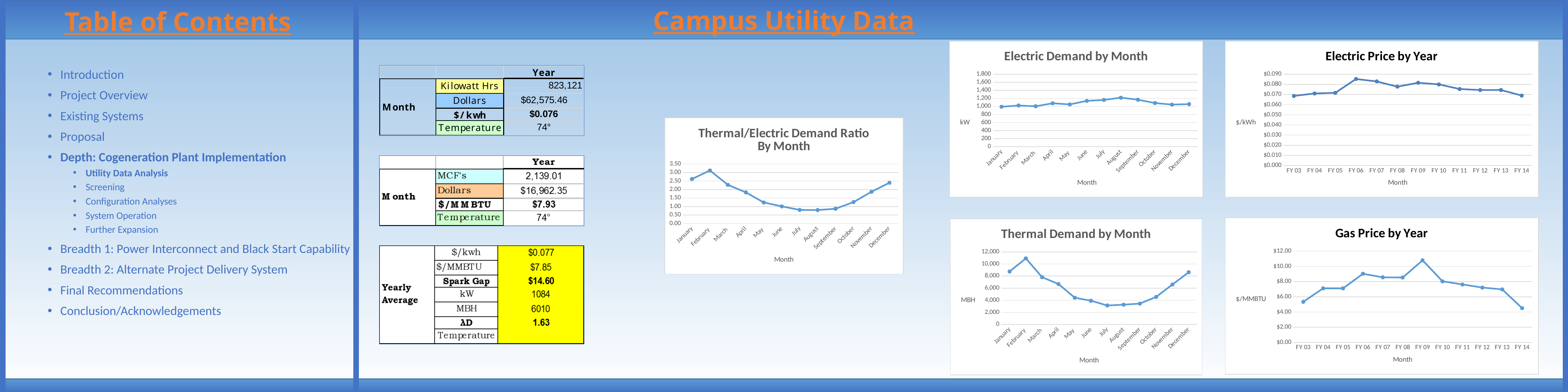
In the "Thermal Demand by Month" chart, which month has the highest demand? February In the "Gas Price by Year" chart, which fiscal year has the highest gas price? FY 09 In the "Thermal Demand by Month" chart, is the value for July greater or less than 4,000? less In the "Electric Demand by Month" chart, which month has the highest demand? August How many months are plotted in the "Electric Demand by Month" chart? 12 In the "Electric Demand by Month" chart, is the value for January greater or less than 1,200? less In the "Gas Price by Year" chart, do values rise or fall from FY 09 to FY 14? fall In the "Electric Price by Year" chart, is the value for FY 06 greater or less than $0.080? greater What kind of chart is the "Thermal/Electric Demand Ratio By Month" chart? line chart In the "Gas Price by Year" chart, which fiscal year has the lowest gas price? FY 14